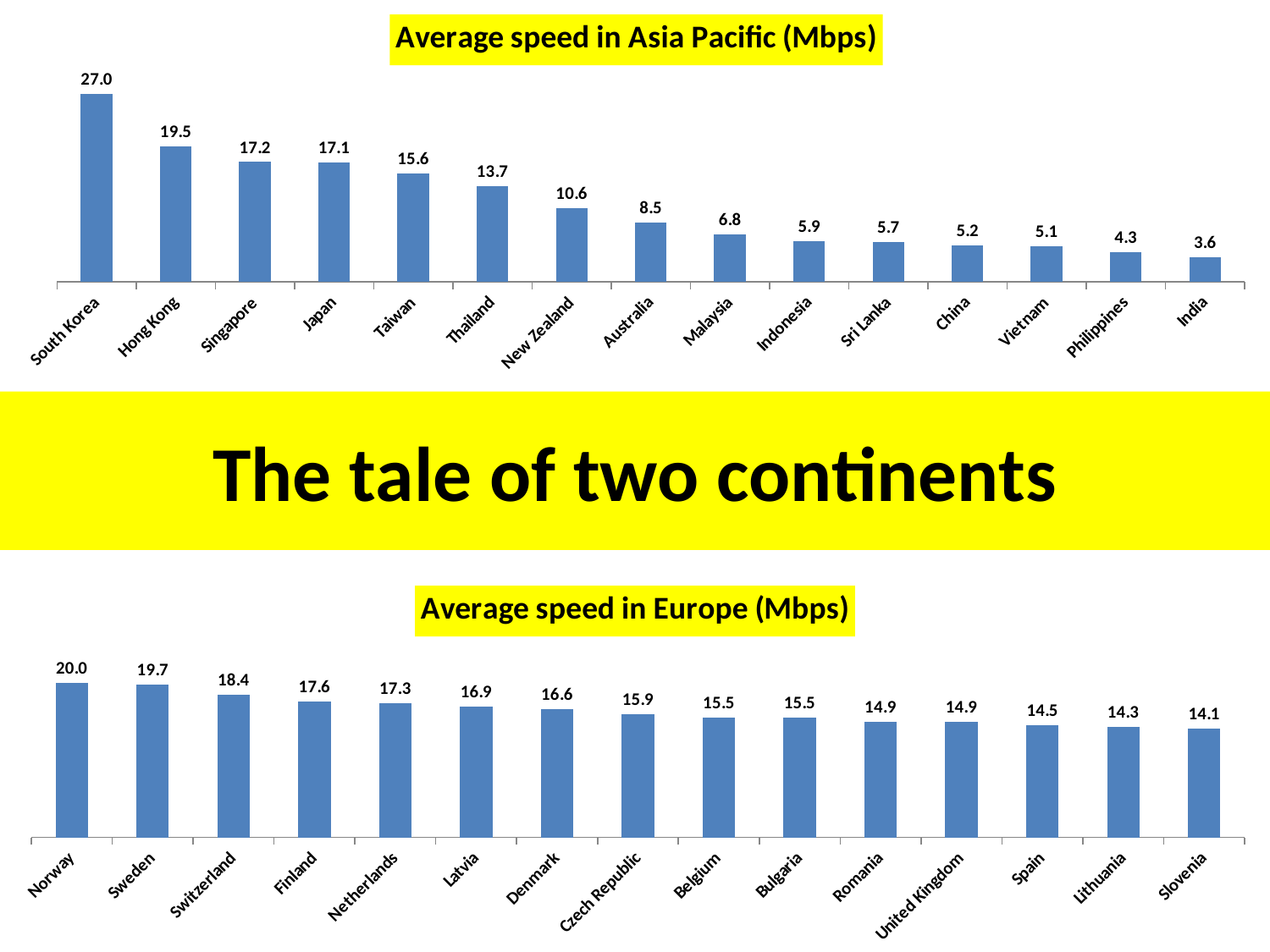
In the 'Average speed in Europe (Mbps)' chart, what is the difference between Norway and Slovenia? 5.9 In the 'Average speed in Asia Pacific (Mbps)' chart, do the values rise or fall from left to right? fall In the 'Average speed in Asia Pacific (Mbps)' chart, what is the difference between South Korea and Hong Kong? 7.5 In the 'Average speed in Asia Pacific (Mbps)' chart, which country has the highest value? South Korea In the 'Average speed in Asia Pacific (Mbps)' chart, which country has the lowest value? India In the 'Average speed in Asia Pacific (Mbps)' chart, what is the value for Japan? 17.1 What kind of chart is the 'Average speed in Europe (Mbps)' chart? bar chart In the 'Average speed in Europe (Mbps)' chart, which country has the lowest value? Slovenia In the 'Average speed in Europe (Mbps)' chart, which country has the highest value? Norway In the 'Average speed in Europe (Mbps)' chart, which is larger, the value for Finland or the value for Denmark? Finland In the 'Average speed in Asia Pacific (Mbps)' chart, how many countries are shown? 15 In the 'Average speed in Europe (Mbps)' chart, what is the value for Netherlands? 17.3